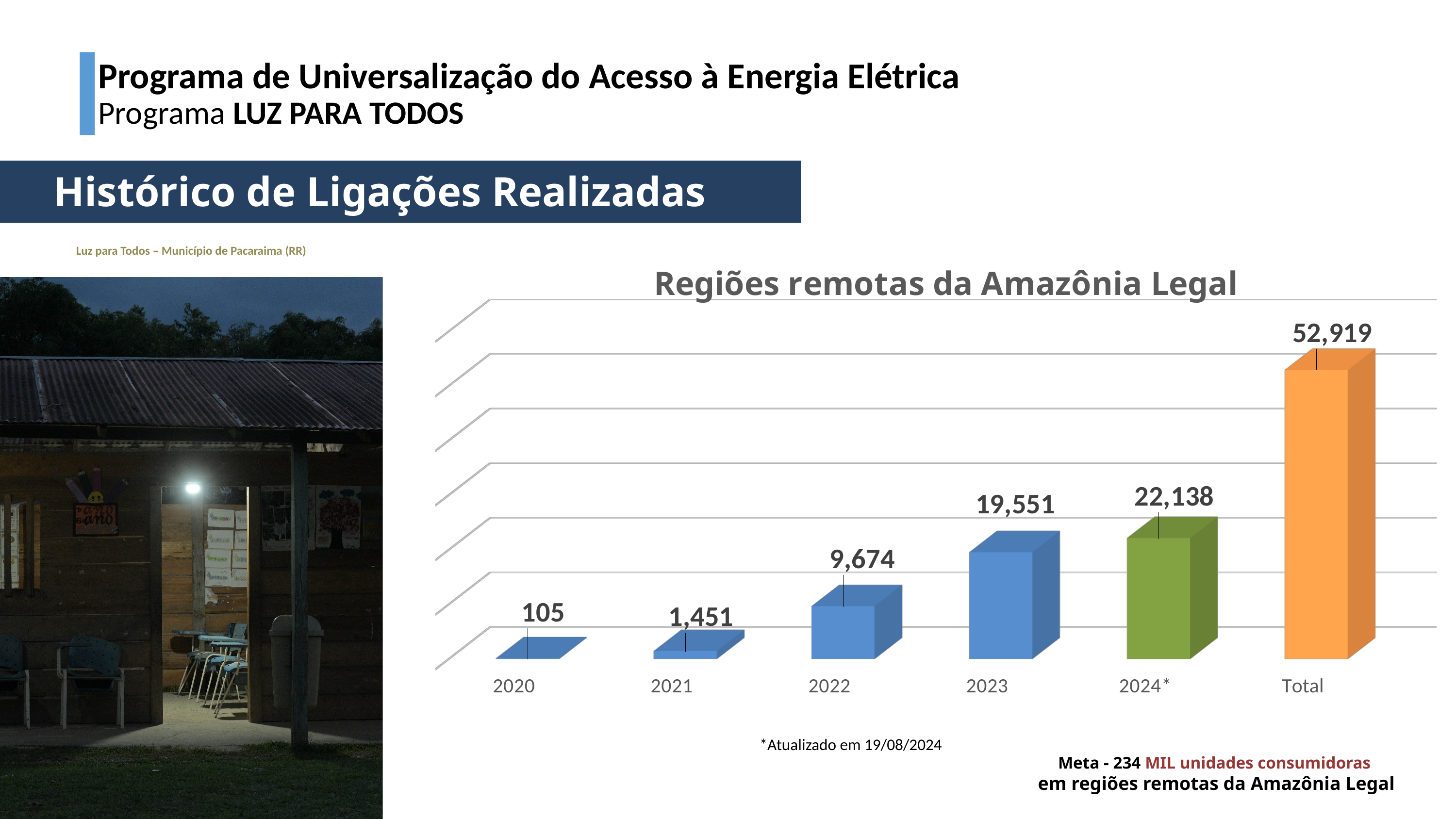
Which year from 2020 to 2024* has the lowest value? 2020 Which year from 2020 to 2024* has the highest value? 2024* Which is larger, the value for 2021 or the value for 2022? 2022 What is the title of the chart? Regiões remotas da Amazônia Legal What is the difference between the values for 2023 and 2022? 9,877 How many bars are shown in the chart? 6 What is the value shown for the Total bar? 52,919 What is the value for 2023 in the chart? 19,551 What is the value for 2020 in the chart? 105 What kind of chart is shown on the slide? Bar chart What is the difference between the values for 2024* and 2023? 2,587 What is the value for 2024* in the chart? 22,138